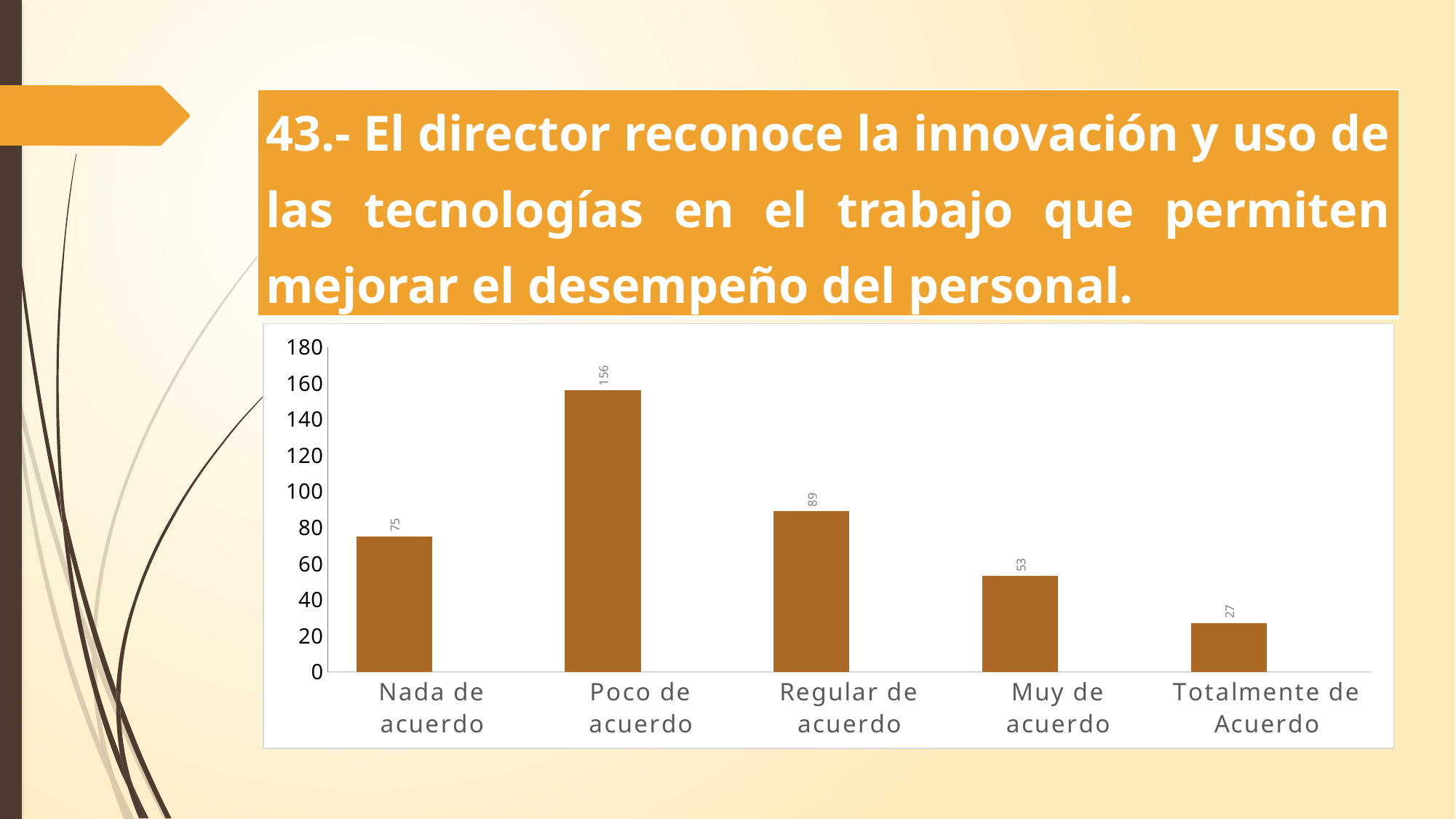
What is the value for "Muy de acuerdo"? 53 What is the value for "Totalmente de Acuerdo"? 27 What is the difference between the values for "Poco de acuerdo" and "Regular de acuerdo"? 67 Which category has the highest value? Poco de acuerdo How many categories are shown on the x axis? 5 Which category has the lowest value? Totalmente de Acuerdo Which is larger, the value for "Nada de acuerdo" or the value for "Muy de acuerdo"? Nada de acuerdo What kind of chart is shown on the slide? bar chart What is the highest value shown on the vertical axis? 180 Is the value for "Regular de acuerdo" greater or less than 100? less What is the value for "Poco de acuerdo"? 156 What is the value for "Nada de acuerdo"? 75